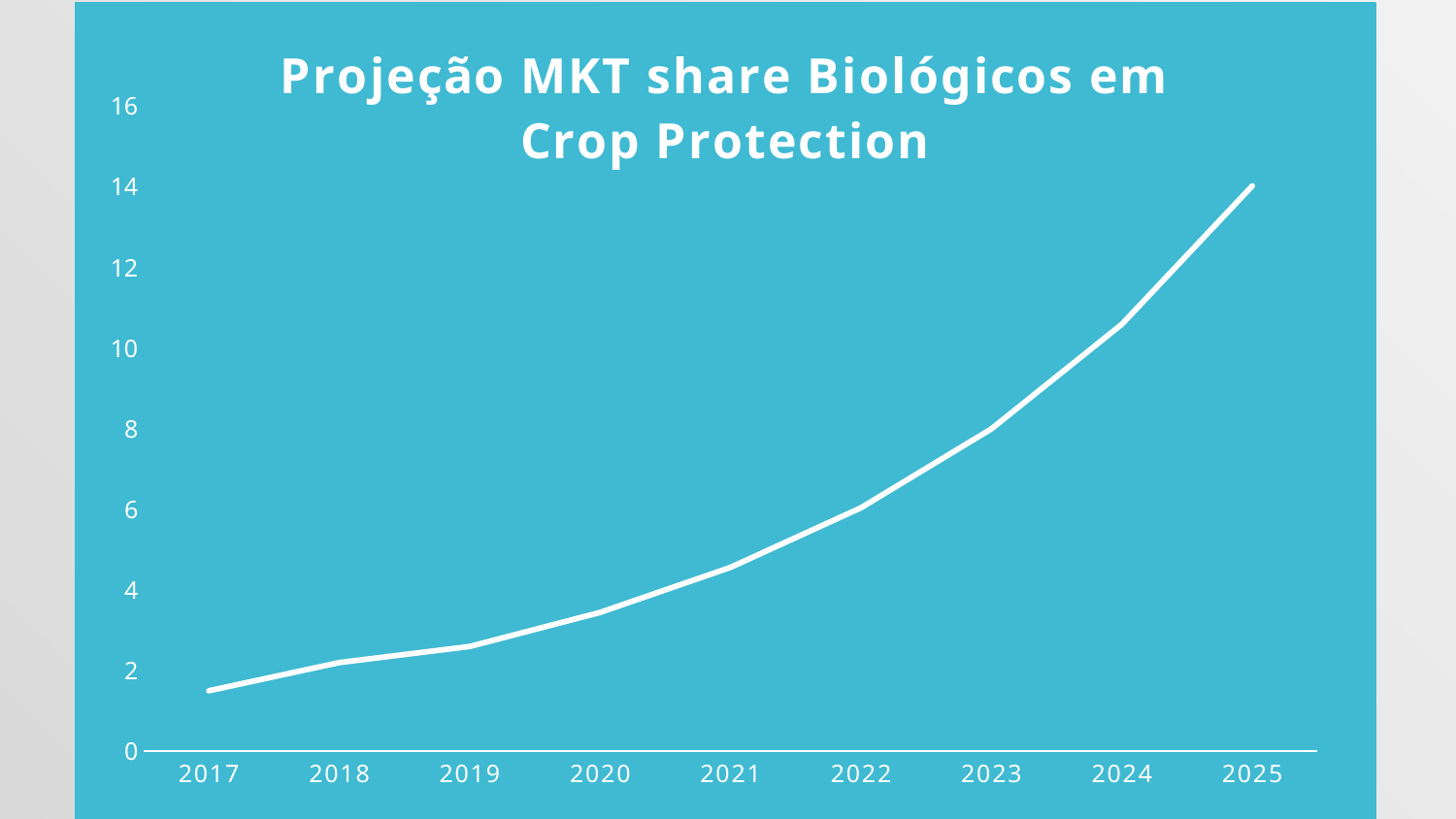
What is the highest value shown on the y axis? 16 Which year has the lowest value? 2017 Is the value for 2024 greater or less than 12? less Do the values rise or fall from 2017 to 2025? rise How many years are plotted along the x axis? 9 What is the title of the chart? Projeção MKT share Biológicos em Crop Protection Is the value for 2017 greater or less than 2? less Is the value for 2025 greater or less than 12? greater What kind of chart is shown on the slide? line chart Which is larger, the value for 2021 or the value for 2023? 2023 Which year has the highest value? 2025